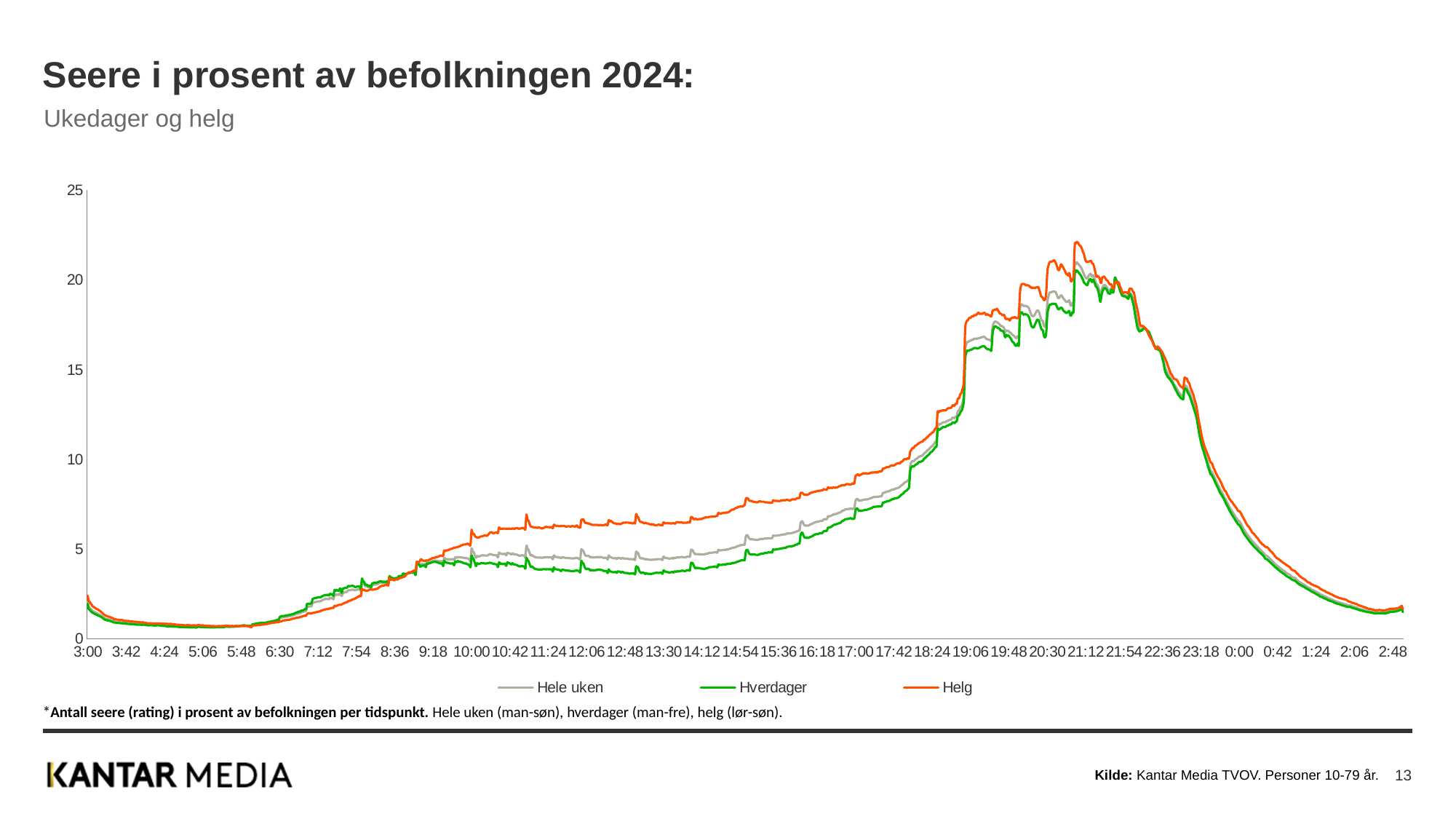
How many series does the legend list? 3 At 13:30, which series has the larger value, Helg or Hverdager? Helg What are the three series named in the legend? Hele uken, Hverdager, Helg What kind of chart is shown on the slide? line chart At 7:12, which series has the larger value, Hverdager or Helg? Hverdager Do the values for Hverdager rise or fall between 21:54 and 2:48? fall Is the value for Helg at 12:06 greater or less than 5? greater Which series reaches the highest peak value in the chart? Helg Is the value for Hverdager at 12:06 greater or less than 5? less Is the value for Hverdager at 0:42 greater or less than 5? less What is the title of the chart on the slide? Seere i prosent av befolkningen 2024: Ukedager og helg